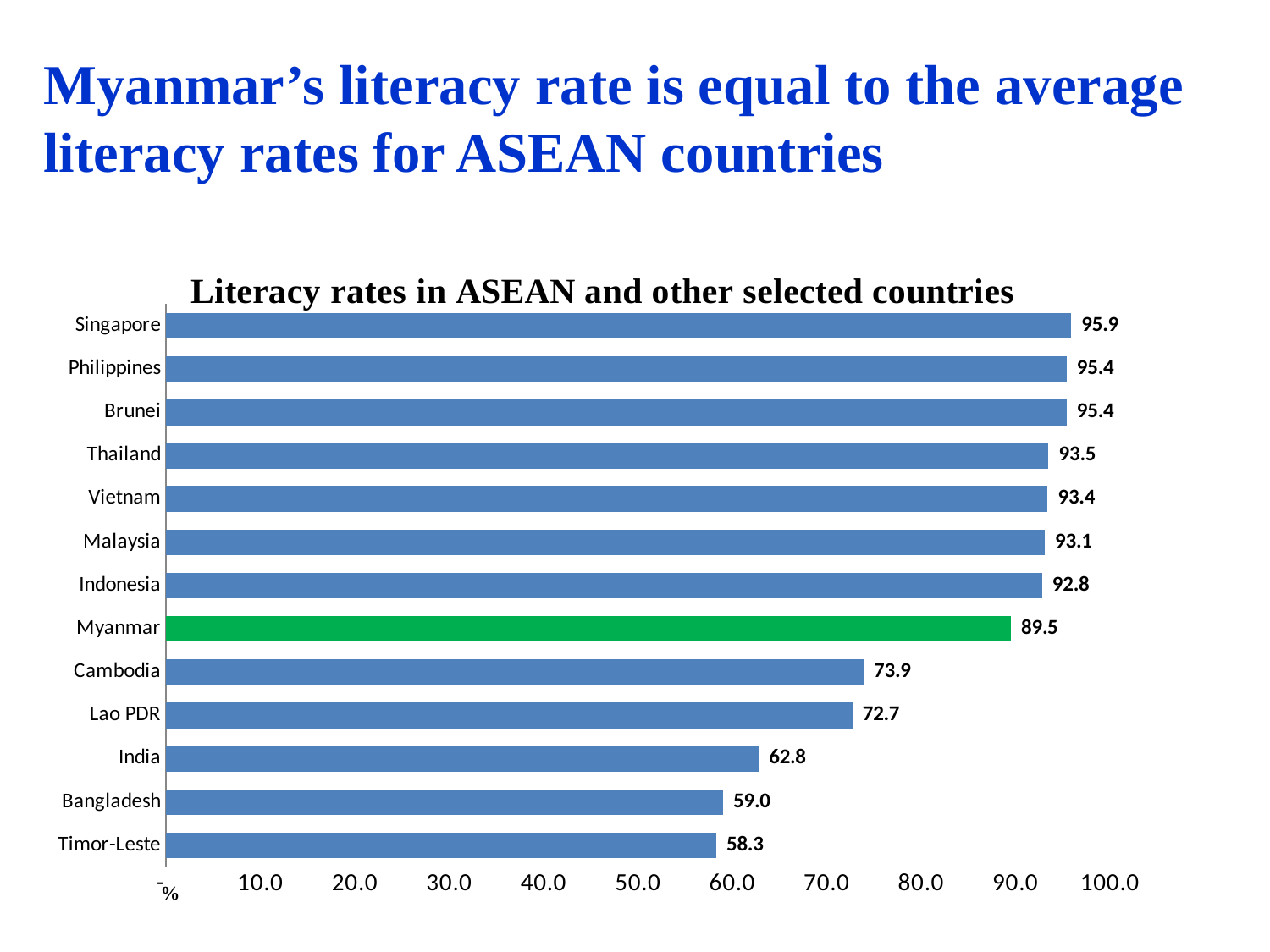
Which country's bar is coloured green instead of blue? Myanmar What is the literacy rate shown for Bangladesh? 59.0 What is the literacy rate shown for Myanmar? 89.5 What kind of chart is shown on the slide? Bar chart Is the literacy rate for Indonesia greater or less than 90.0? greater Which country has the highest literacy rate on the chart? Singapore What is the literacy rate shown for Cambodia? 73.9 Which has a higher literacy rate, India or Lao PDR? Lao PDR What is the difference between the literacy rates of Myanmar and Cambodia? 15.6 What is the difference between the literacy rates of Singapore and Timor-Leste? 37.6 How many countries are shown on the chart? 13 Which country has the lowest literacy rate on the chart? Timor-Leste